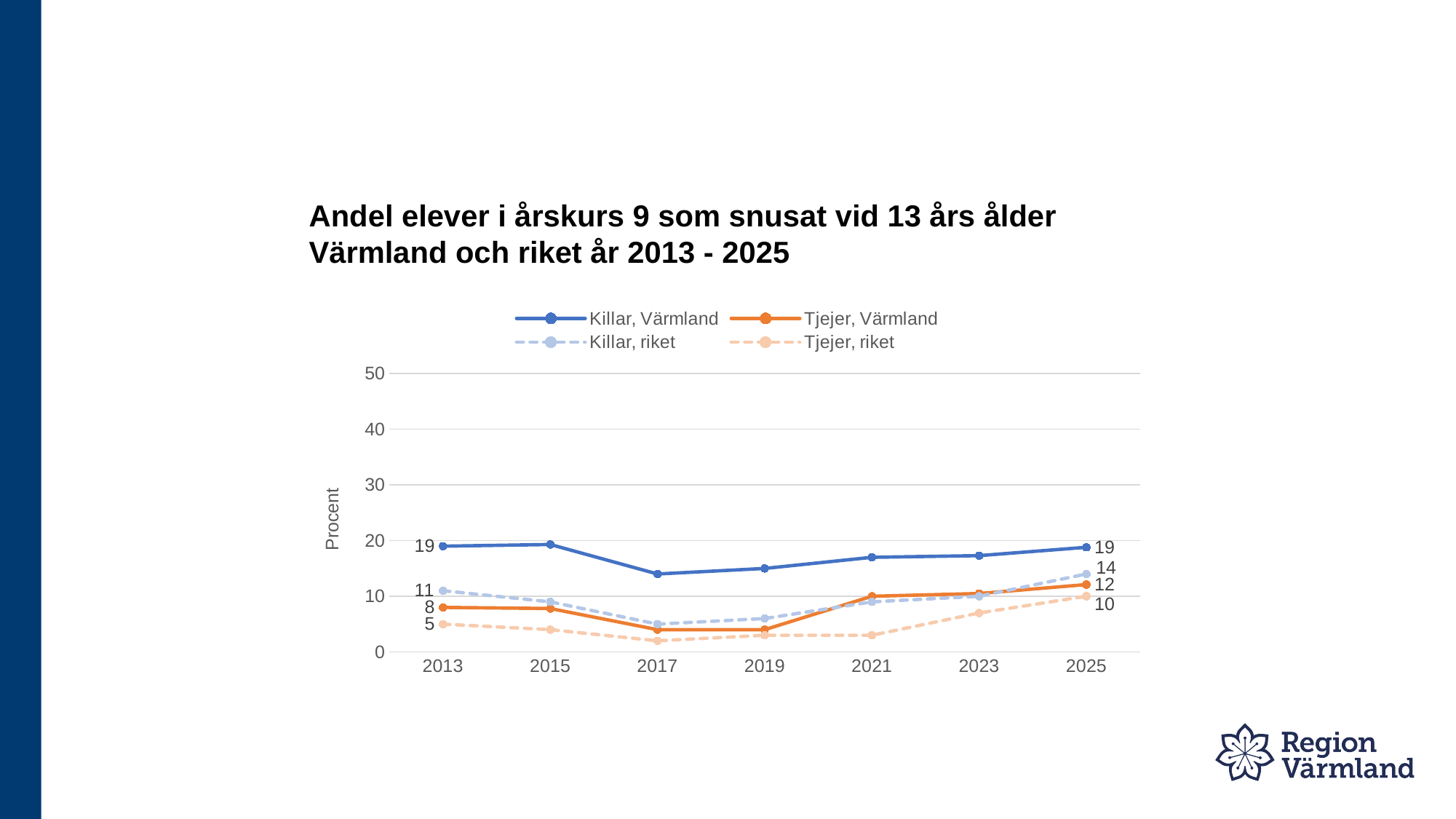
What is the difference between Tjejer, riket in 2025 and Tjejer, riket in 2013? 5 How many years are shown on the x axis? 7 Which series has the highest value in 2025? Killar, Värmland Is the value for Killar, Värmland in 2017 greater or less than 10? greater What is the value for Killar, riket in 2013? 11 What type of chart is shown on the slide? line chart How many series does the legend list? 4 What is the value for Tjejer, Värmland in 2025? 12 What is the value for Tjejer, riket in 2025? 10 Which series has the lowest value in 2013? Tjejer, riket What is the difference between Killar, Värmland and Tjejer, Värmland in 2013? 11 What is the value for Killar, Värmland in 2013? 19